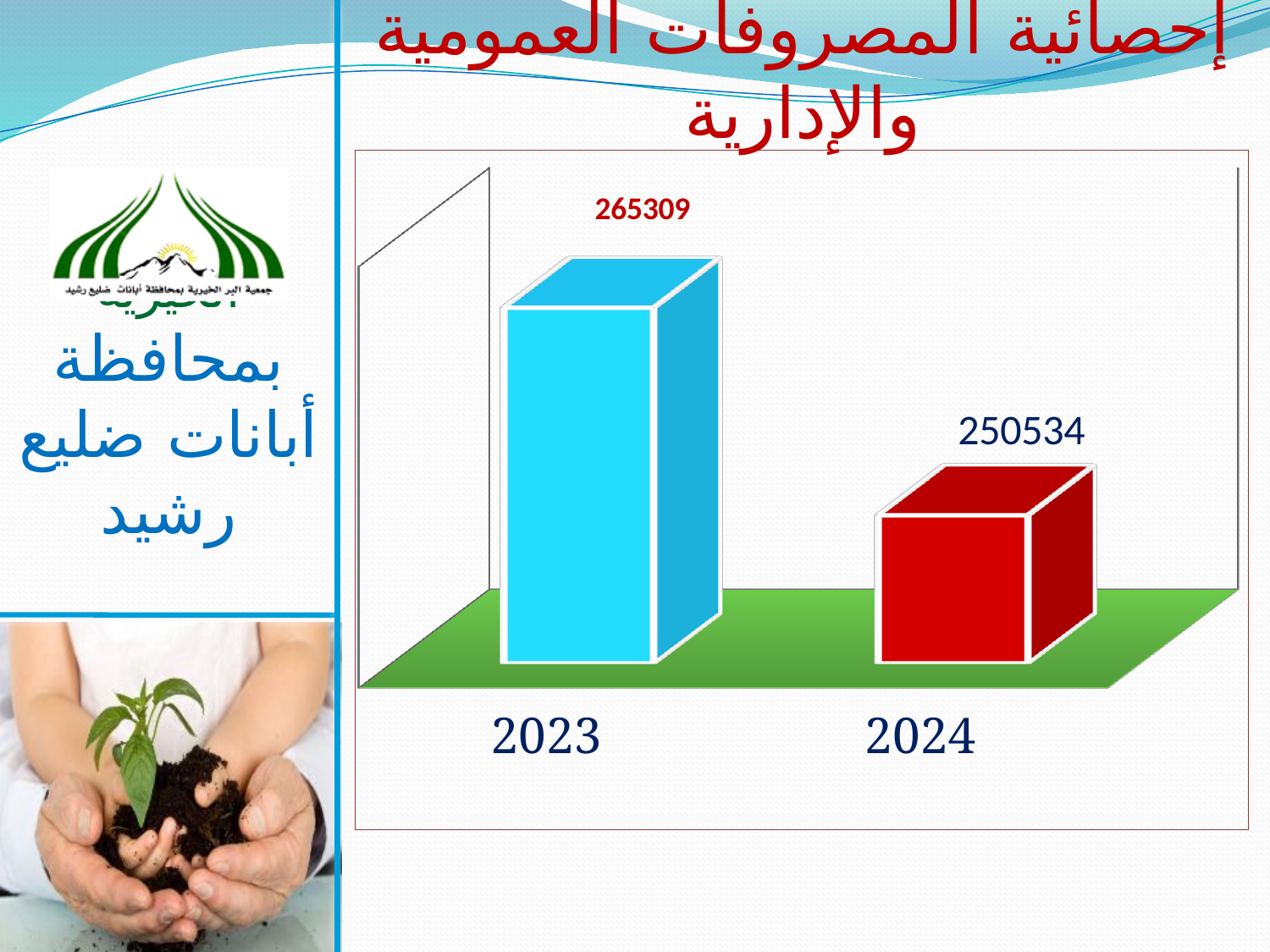
What is the difference between the 2023 value and the 2024 value? 14775 How many categories are plotted on the chart? 2 Is the value for 2024 larger or smaller than the value for 2023? smaller What is the value shown for 2024? 250534 Do the values rise or fall from 2023 to 2024? fall What colour is the bar for 2024? red What kind of chart is shown on the slide? bar chart Which year has the higher value? 2023 What colour is the bar for 2023? blue Which year has the lower value? 2024 What is the value shown for 2023? 265309